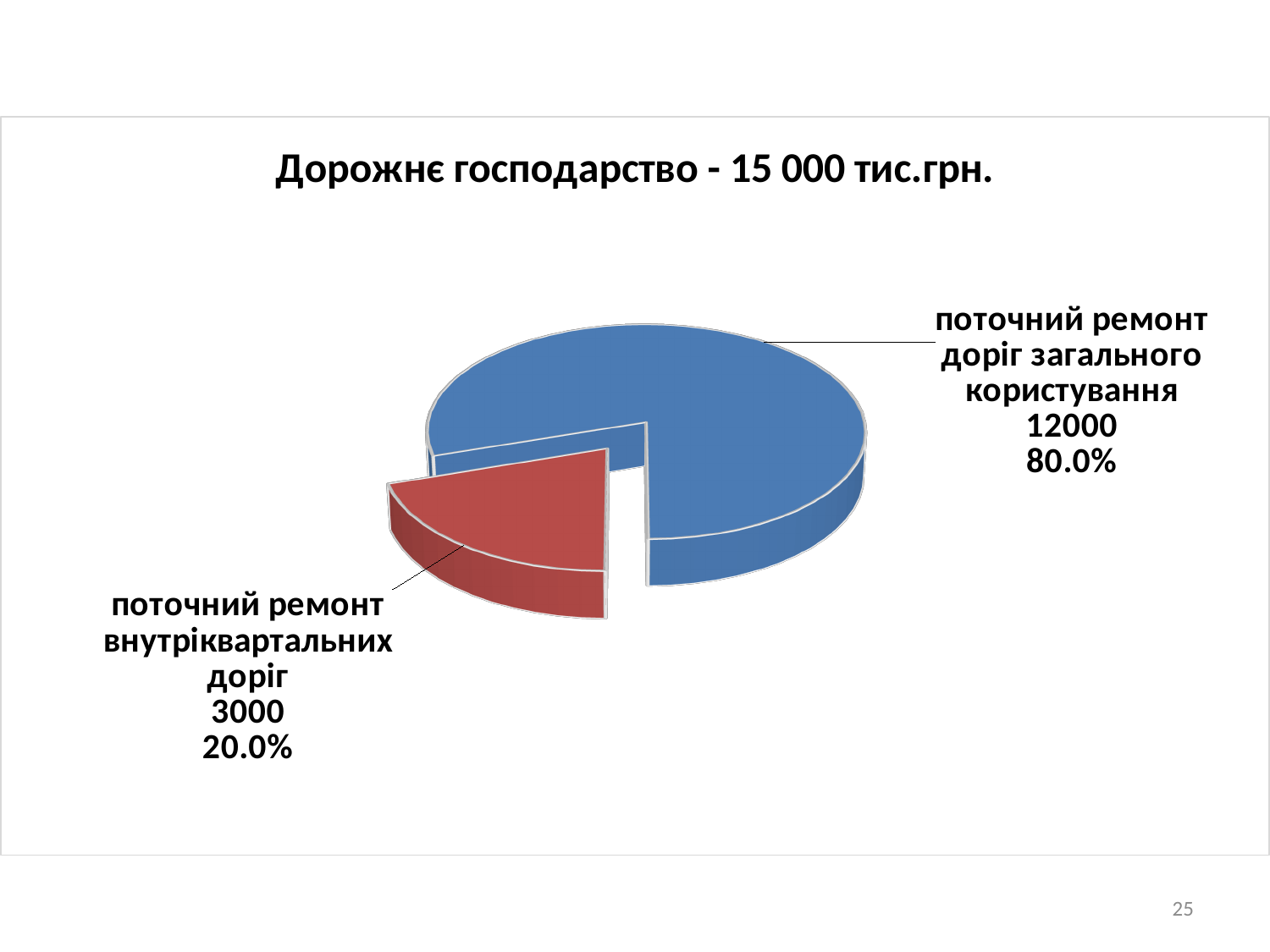
What share of the pie does поточний ремонт доріг загального користування represent? 80.0% What is the title of the chart? Дорожнє господарство - 15 000 тис.грн. What is the difference between the values for поточний ремонт доріг загального користування and поточний ремонт внутріквартальних доріг? 9000 Which category has the largest slice? поточний ремонт доріг загального користування Which is larger: поточний ремонт внутріквартальних доріг or поточний ремонт доріг загального користування? поточний ремонт доріг загального користування What is the value for поточний ремонт внутріквартальних доріг? 3000 What share of the pie does поточний ремонт внутріквартальних доріг represent? 20.0% Which category has the smallest slice? поточний ремонт внутріквартальних доріг How many slices does the pie chart have? 2 What kind of chart is shown on the slide? pie chart What is the value for поточний ремонт доріг загального користування? 12000 What colour is the slice for поточний ремонт внутріквартальних доріг? red